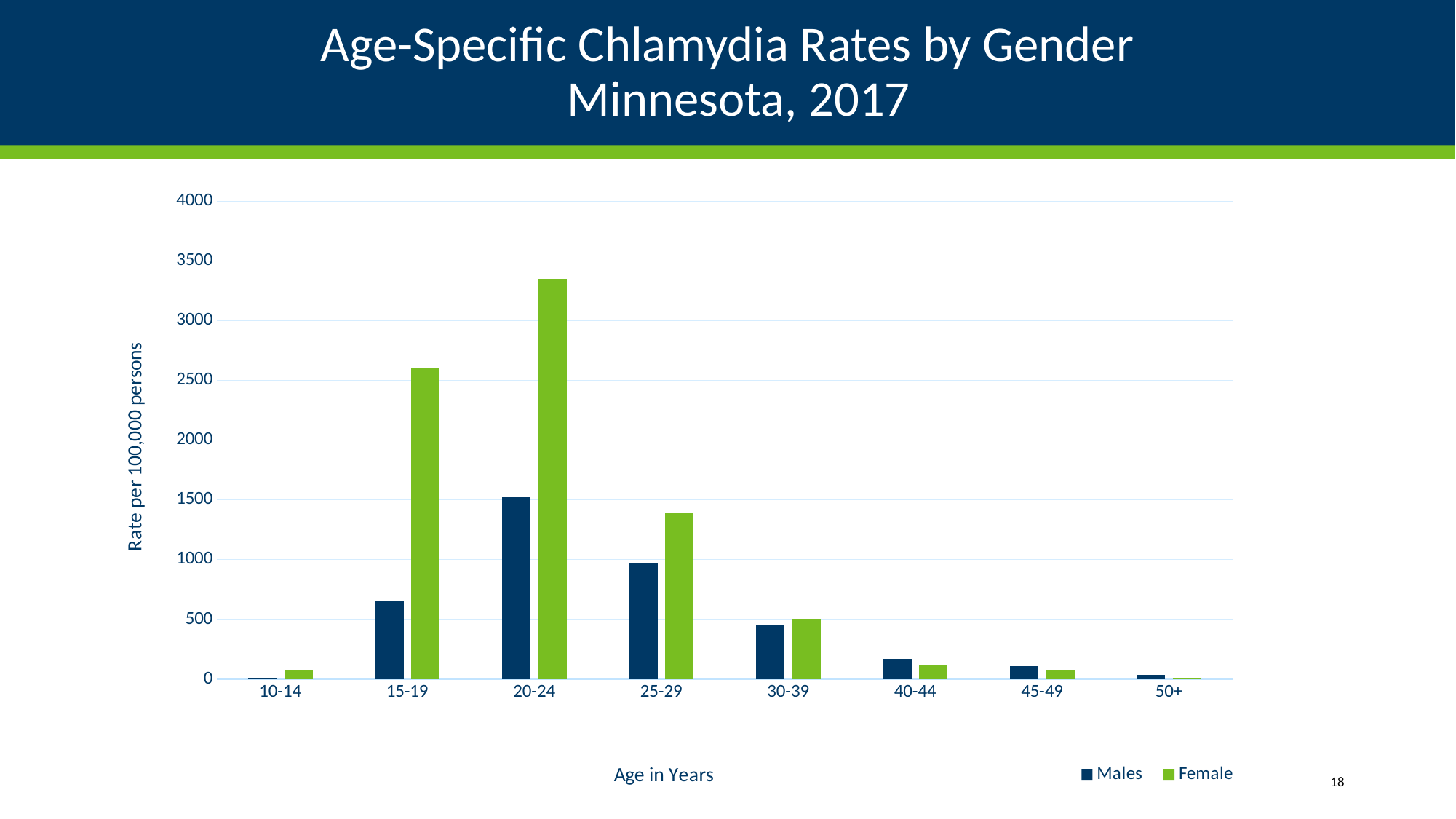
How many age groups are shown on the x axis? 8 Which age group has the lowest Female chlamydia rate? 50+ What kind of chart is shown on the slide? bar chart Is the Female value for 20-24 greater or less than 3000? greater How many series does the legend list? 2 Is the Males value for 20-24 greater or less than 1000? greater Is the Female value for 15-19 greater or less than 2000? greater Which is larger for the 40-44 age group, the Males value or the Female value? Males What is the title of the y axis? Rate per 100,000 persons Which age group has the highest Males chlamydia rate? 20-24 Which age group has the highest Female chlamydia rate? 20-24 Do the Female values rise or fall across the age groups from 20-24 to 50+? fall